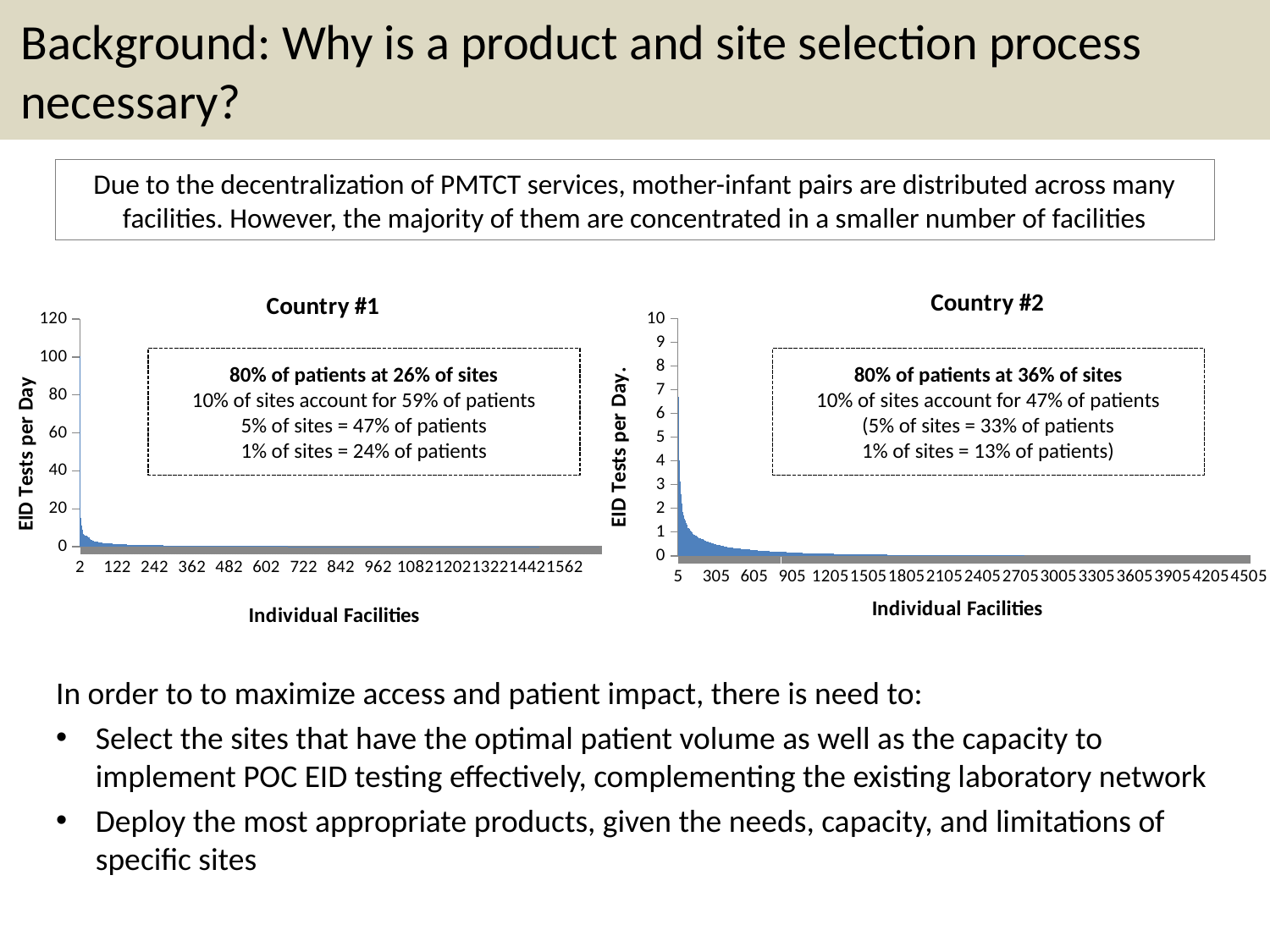
What kind of chart is the Country #2 chart? bar chart In the Country #1 chart, is the value for the first (leftmost) facility greater or less than 80? greater In the Country #1 chart, do the values rise or fall as you move along the x axis from left to right? fall In the Country #2 chart, do the values rise or fall as you move along the x axis from left to right? fall What kind of chart is the Country #1 chart? bar chart In the Country #2 chart, is the value for facility 2405 greater or less than 1? less In the Country #2 chart, is the value for the first (leftmost) facility greater or less than 2? greater What is the x-axis label on the Country #2 chart? Individual Facilities What is the y-axis label on the Country #1 chart? EID Tests per Day